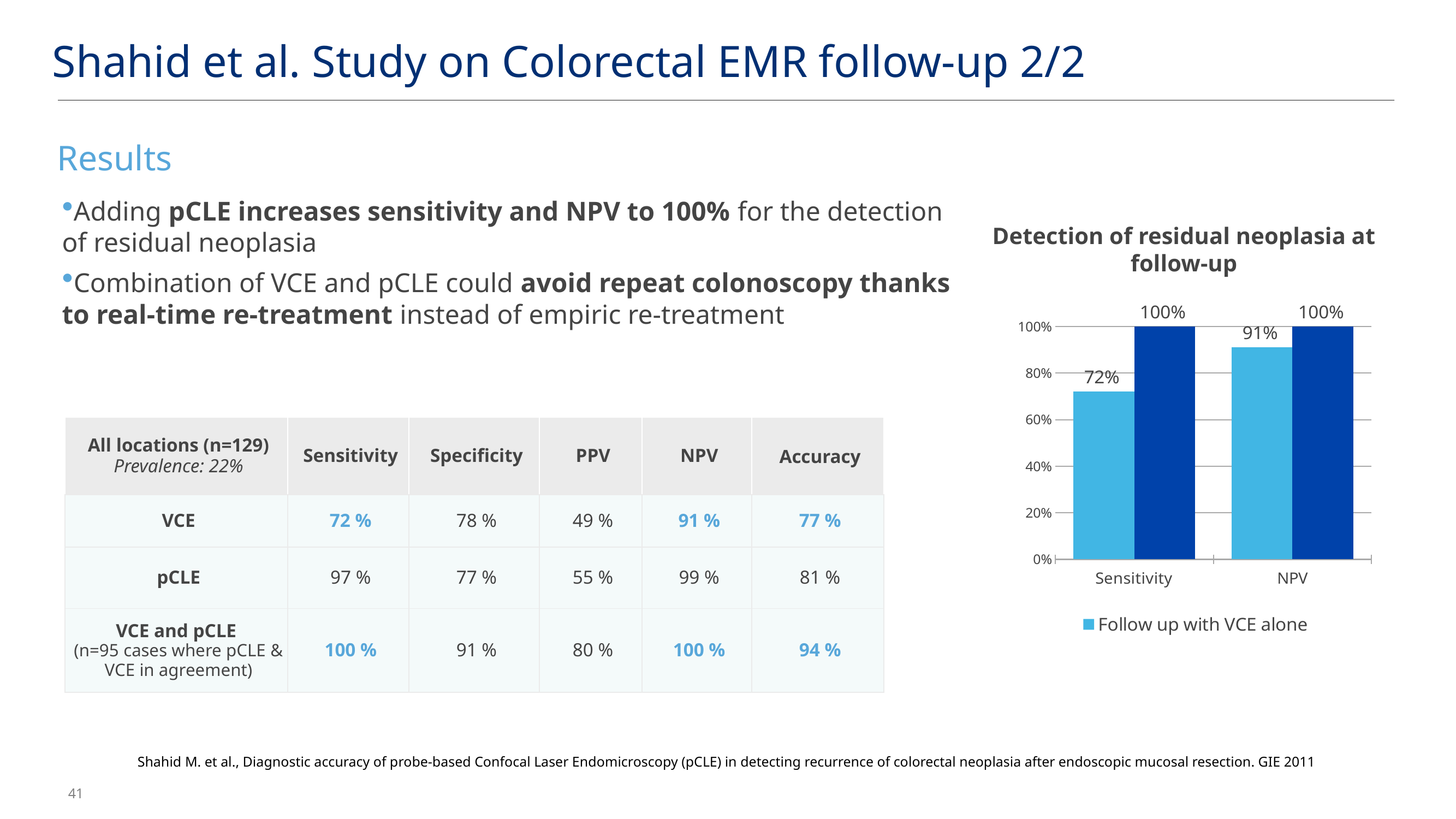
What is the value for Sensitivity in the 'Follow up with VCE alone' series? 72% How many series does the chart's legend list? 1 How many categories are shown on the x axis of the chart? 2 For Sensitivity, what is the difference between the dark blue bar and the 'Follow up with VCE alone' bar? 28% Is the 'Follow up with VCE alone' value for Sensitivity greater or less than 80%? less What is the title of the chart? Detection of residual neoplasia at follow-up What is the value of the dark blue bar for NPV? 100% What is the difference between the NPV and Sensitivity values in the 'Follow up with VCE alone' series? 19% What is the value for NPV in the 'Follow up with VCE alone' series? 91% What is the value of the dark blue bar for Sensitivity? 100% Which category has the lower value in the 'Follow up with VCE alone' series? Sensitivity What kind of chart is shown on the slide? bar chart